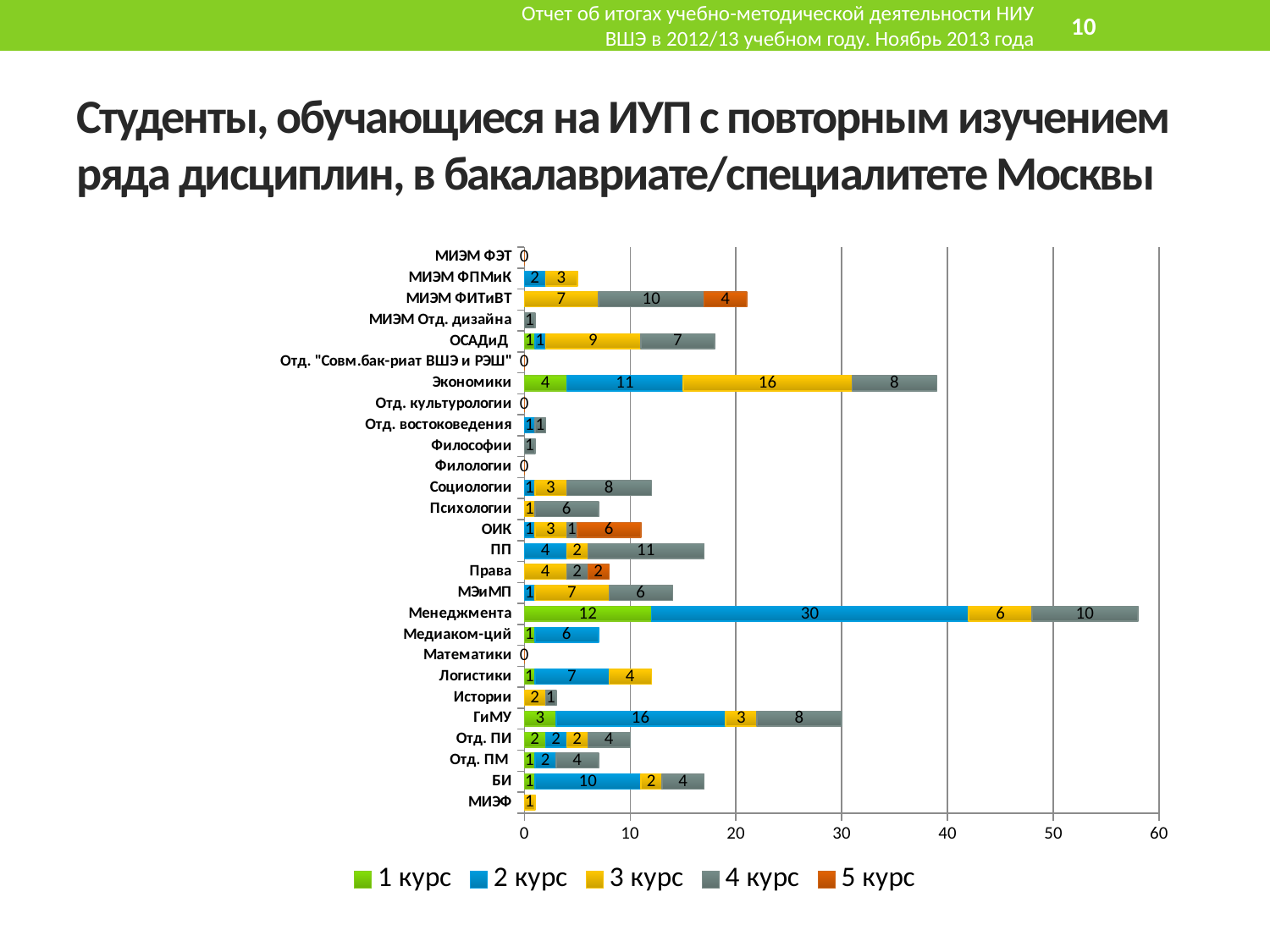
Which category has the largest total bar? Менеджмента Which is larger: the 4 курс value for Социологии or the 4 курс value for Психологии? Социологии What is the value for 5 курс in the МИЭМ ФИТиВТ category? 4 What is the difference between the 2 курс values for Менеджмента and ГиМУ? 14 What kind of chart is shown on the slide? stacked bar chart How many series does the legend list? 5 What is the value for 2 курс in the Менеджмента category? 30 What is the value for 4 курс in the ПП category? 11 What is the total of the stacked bar for Экономики? 39 What is the total of the stacked bar for Менеджмента? 58 What is the value for 3 курс in the Экономики category? 16 How many categories (faculties/departments) are shown on the chart? 27